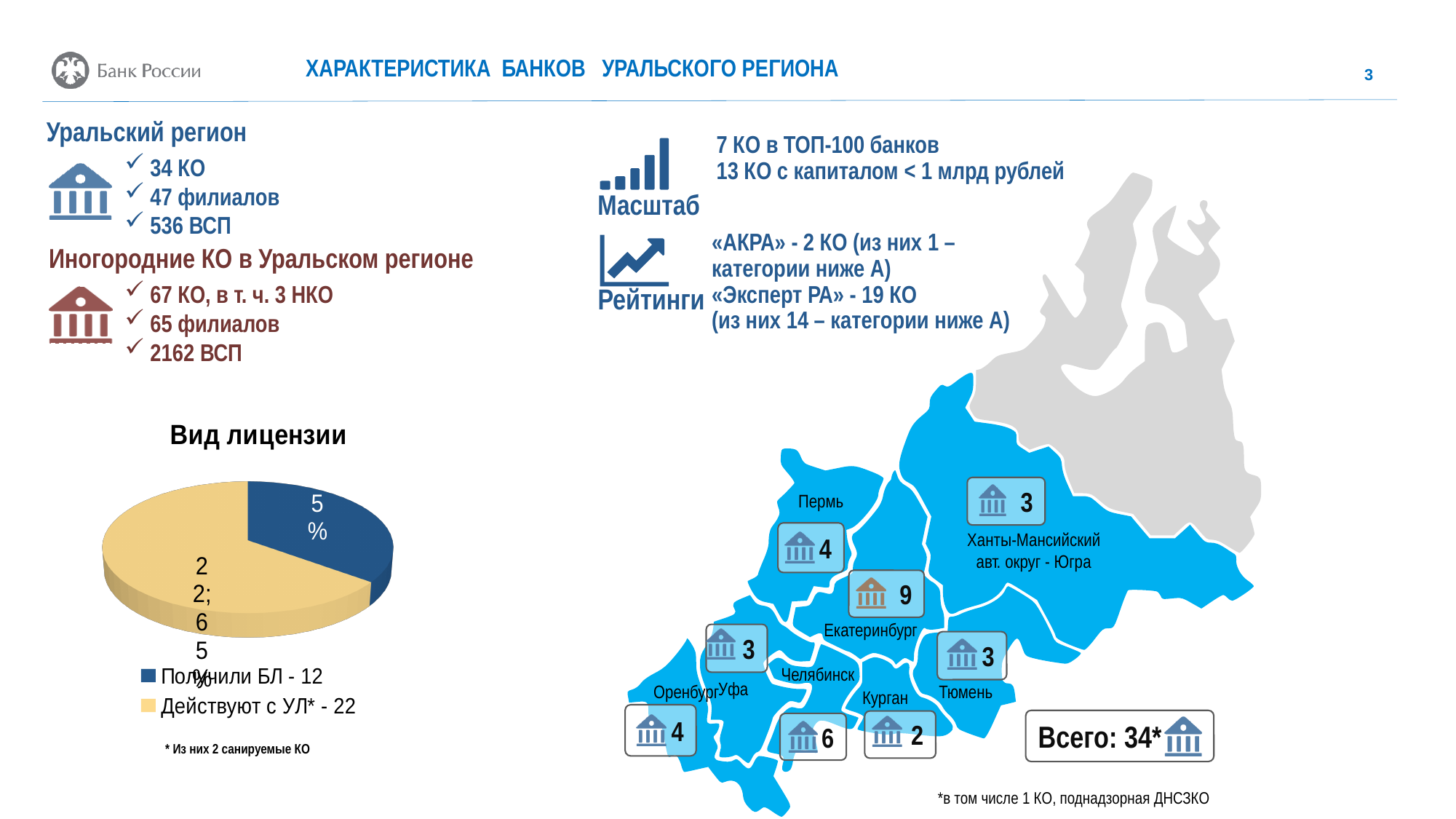
In the "Вид лицензии" chart, what is the difference between "Действуют с УЛ*" and "Получили БЛ"? 10 In the "Вид лицензии" chart, which category has the smaller value? Получили БЛ What is the title of the pie chart on the slide? Вид лицензии In the "Вид лицензии" chart, is the value for "Получили БЛ" larger or smaller than the value for "Действуют с УЛ*"? smaller In the "Вид лицензии" chart, what is the value for "Получили БЛ"? 12 In the "Вид лицензии" chart, what is the value for "Действуют с УЛ*"? 22 In the "Вид лицензии" chart, what colour is the "Получили БЛ" slice? dark blue How many slices does the "Вид лицензии" pie chart have? 2 In the "Вид лицензии" chart, which category has the larger value? Действуют с УЛ* In the "Вид лицензии" chart, what is the total of the two slices? 34 What kind of chart is the "Вид лицензии" chart? pie chart How many entries does the legend of the "Вид лицензии" chart list? 2